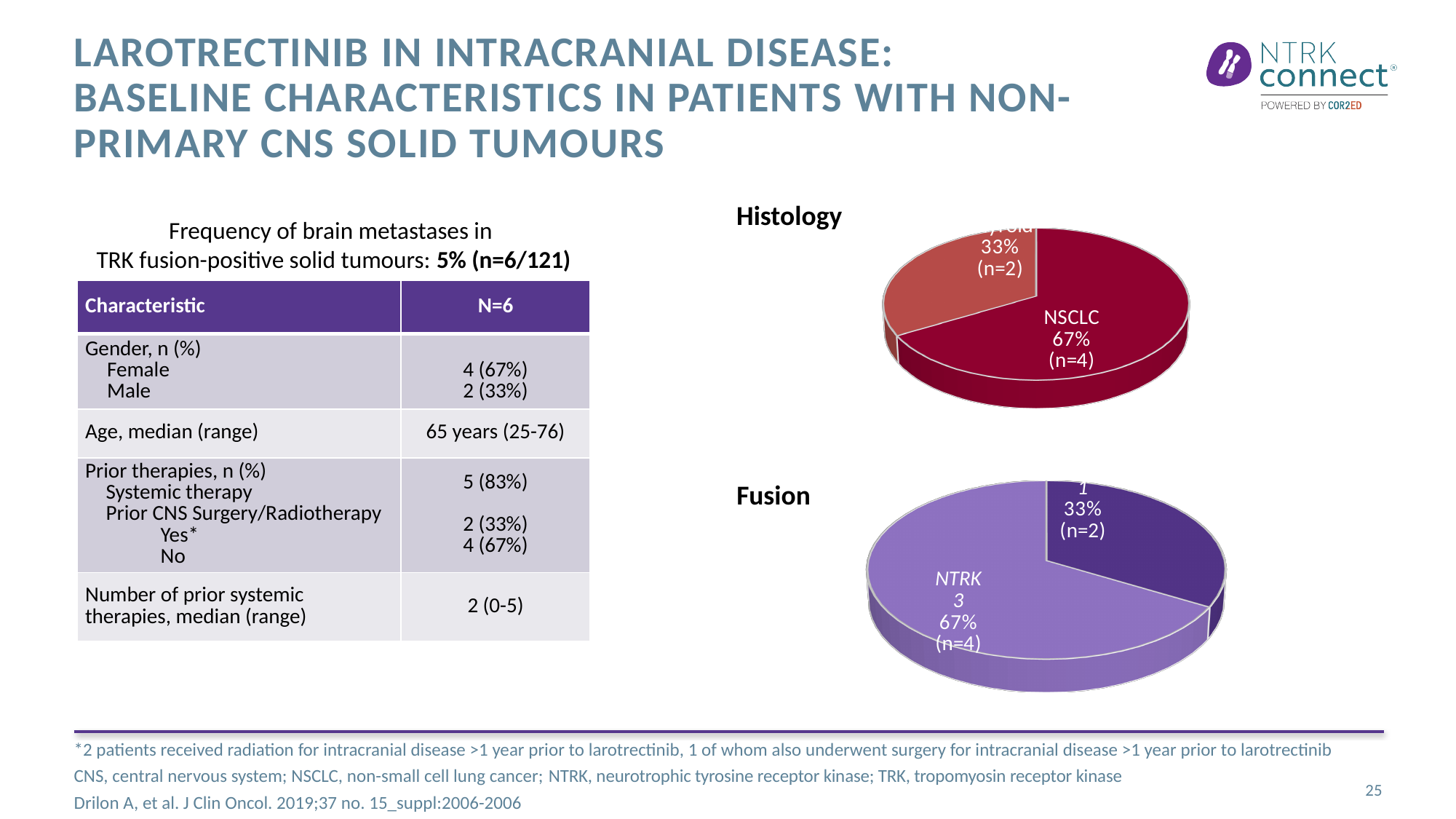
What kind of chart is the Fusion chart? pie chart In the Fusion pie chart, how many patients (n) had an NTRK3 fusion? n=4 What is the title of the lower pie chart on the slide? Fusion How many slices does the Histology pie chart have? 2 What kind of chart is the Histology chart? pie chart In the Histology pie chart, which histology has the largest slice? NSCLC In the Histology pie chart, what percentage of patients had NSCLC? 67% In the Fusion pie chart, what percentage of patients had an NTRK3 fusion? 67% In the Fusion pie chart, which fusion has the largest slice? NTRK3 In the Histology pie chart, what is the difference in percentage points between the NSCLC slice and the other slice? 34 percentage points How many slices does the Fusion pie chart have? 2 In the Histology pie chart, how many patients (n) had NSCLC? n=4